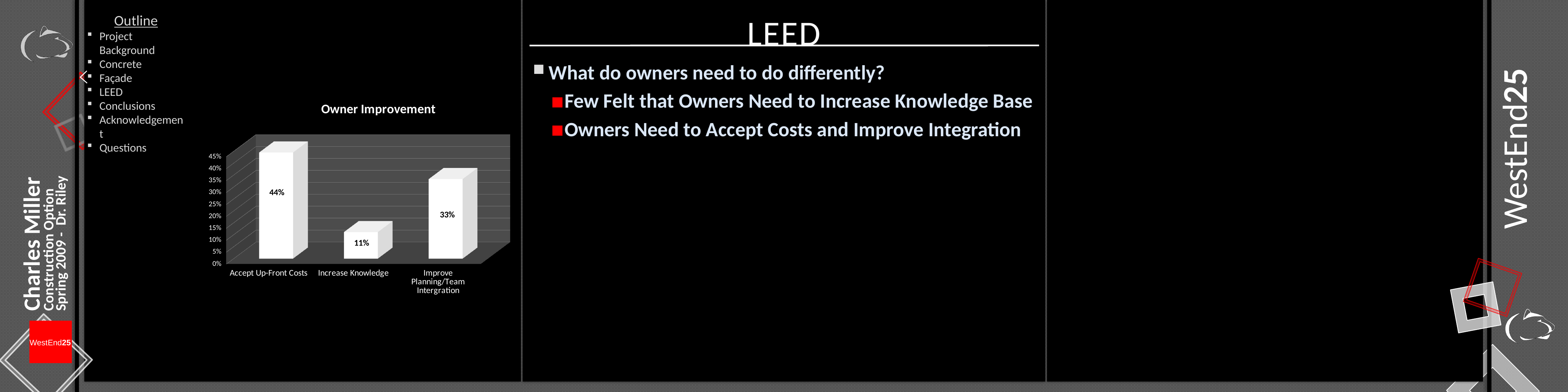
What is the difference between the values for Accept Up-Front Costs and Improve Planning/Team Intergration? 11% What is the title of the chart on the slide? Owner Improvement Which is larger: the value for Improve Planning/Team Intergration or the value for Increase Knowledge? Improve Planning/Team Intergration What is the difference between the values for Accept Up-Front Costs and Increase Knowledge? 33% What is the value for Accept Up-Front Costs in the Owner Improvement chart? 44% What is the value for Improve Planning/Team Intergration in the Owner Improvement chart? 33% How many categories are shown in the Owner Improvement chart? 3 What is the value for Increase Knowledge in the Owner Improvement chart? 11% What kind of chart is the Owner Improvement chart? bar chart Which category has the lowest value in the Owner Improvement chart? Increase Knowledge Is the value for Improve Planning/Team Intergration greater or less than 20%? greater Which category has the highest value in the Owner Improvement chart? Accept Up-Front Costs